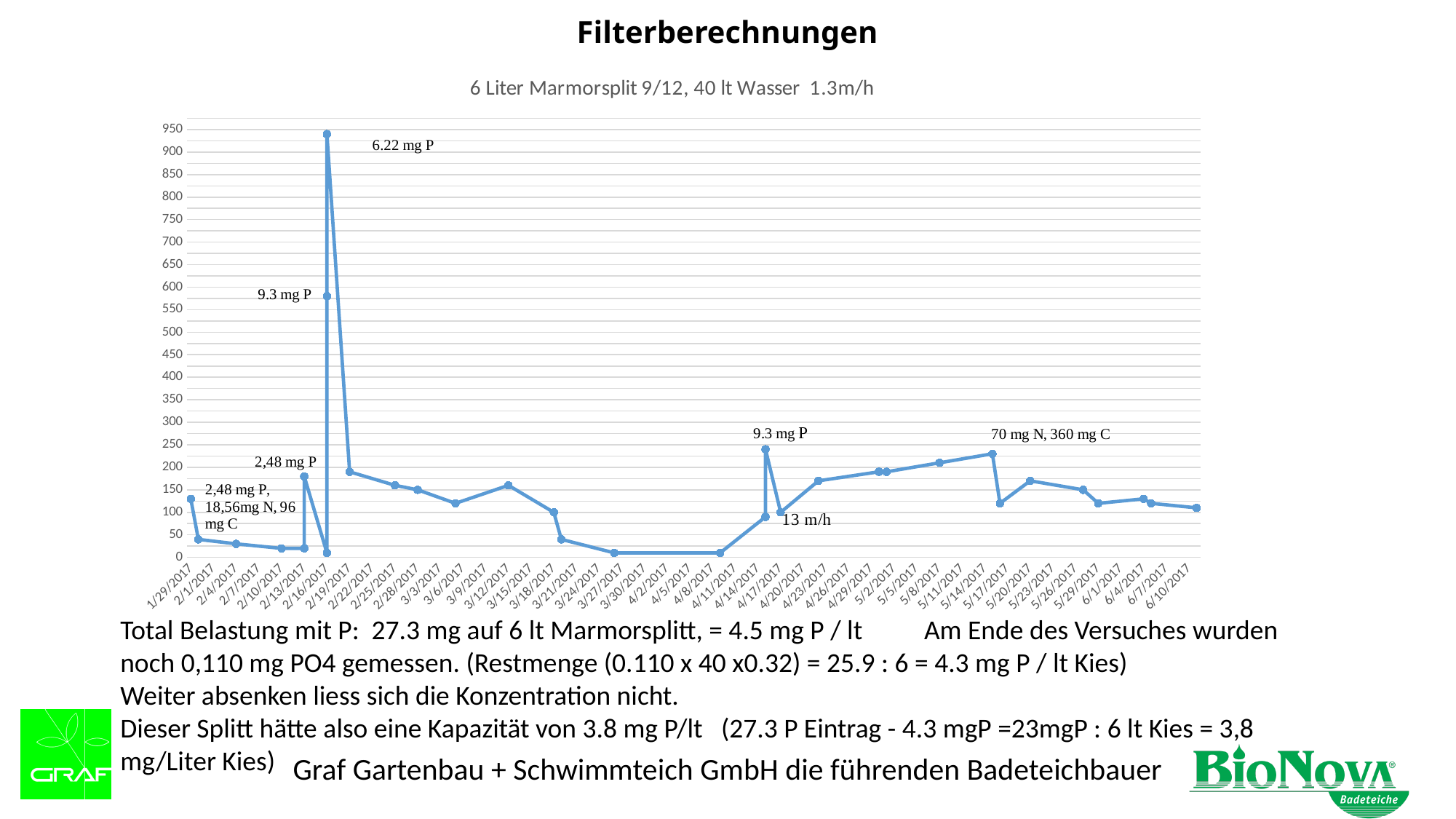
Do the values rise or fall from 4/20/2017 to 5/14/2017? rise Which date on the x axis has the highest plotted value? 2/16/2017 What kind of chart is shown on the slide? line chart Which is larger, the peak value near 2/16/2017 or the peak value near 4/17/2017? 2/16/2017 What annotation is written next to the highest peak of the chart? 6.22 mg P Is the value at 6/10/2017 greater or less than 150? less Is the value at 3/27/2017 greater or less than 50? less Is the value at 1/29/2017 greater or less than 100? greater What is the title of the chart? 6 Liter Marmorsplit 9/12, 40 lt Wasser 1.3m/h Do the values rise or fall from 2/19/2017 to 3/6/2017? fall